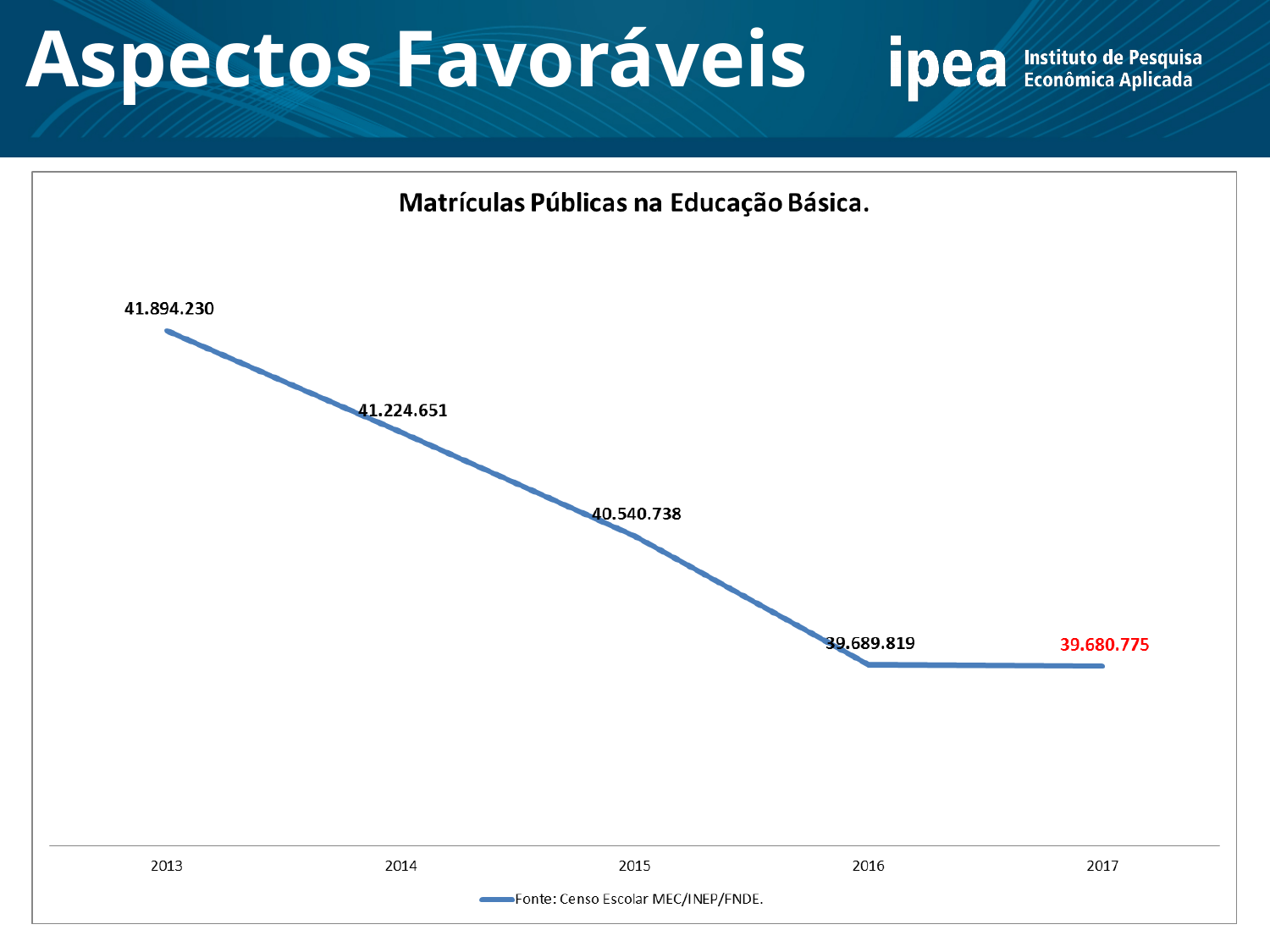
What is the difference between the values for 2013 and 2014? 669.579 What is the value for 2015? 40.540.738 Which is larger, the value for 2014 or the value for 2015? 2014 What is the value for 2013? 41.894.230 What is the difference between the values for 2016 and 2017? 9.044 Which year has the highest value? 2013 What is the title of the chart? Matrículas Públicas na Educação Básica. How many years are plotted on the x axis? 5 What is the value for 2017? 39.680.775 Do the values rise or fall from 2013 to 2017? fall What kind of chart is this? line chart Which year has the lowest value? 2017